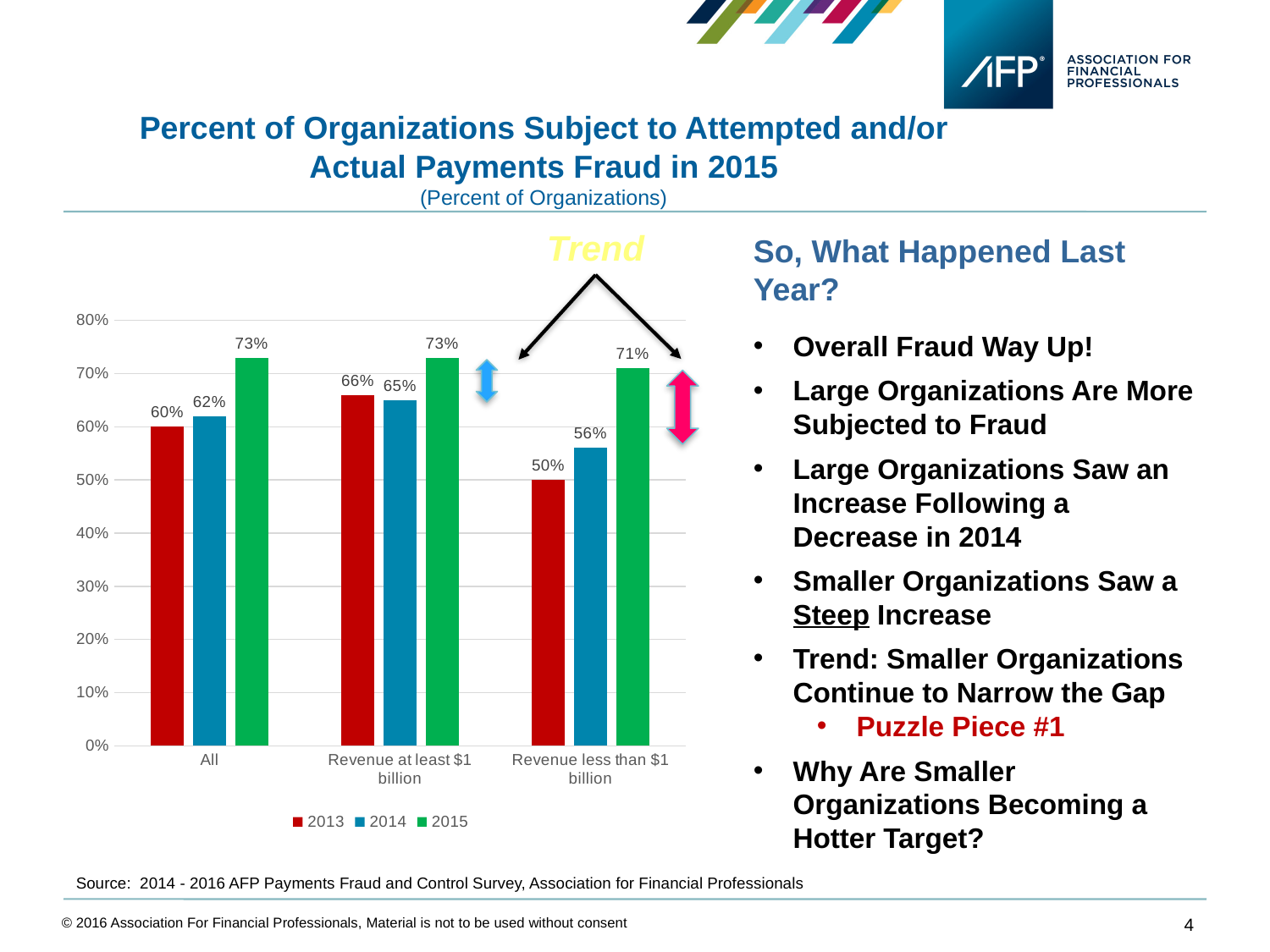
Which category has the lowest value for 2013? Revenue less than $1 billion How many series does the legend list? 3 Which is larger in the 'Revenue at least $1 billion' category, the 2013 value or the 2014 value? 2013 What is the difference between the 2015 and 2013 values for 'Revenue less than $1 billion'? 21% How many categories are shown on the x axis? 3 What is the difference between the 2014 and 2013 values for 'All'? 2% Which year has the highest value in the 'Revenue less than $1 billion' category? 2015 Do the values for 'Revenue less than $1 billion' rise or fall from 2013 to 2015? Rise What kind of chart is shown on the slide? Bar chart What is the value for 2013 in the 'Revenue less than $1 billion' category? 50% What is the value for 2014 in the 'Revenue at least $1 billion' category? 65% What is the value for 2015 in the 'All' category? 73%